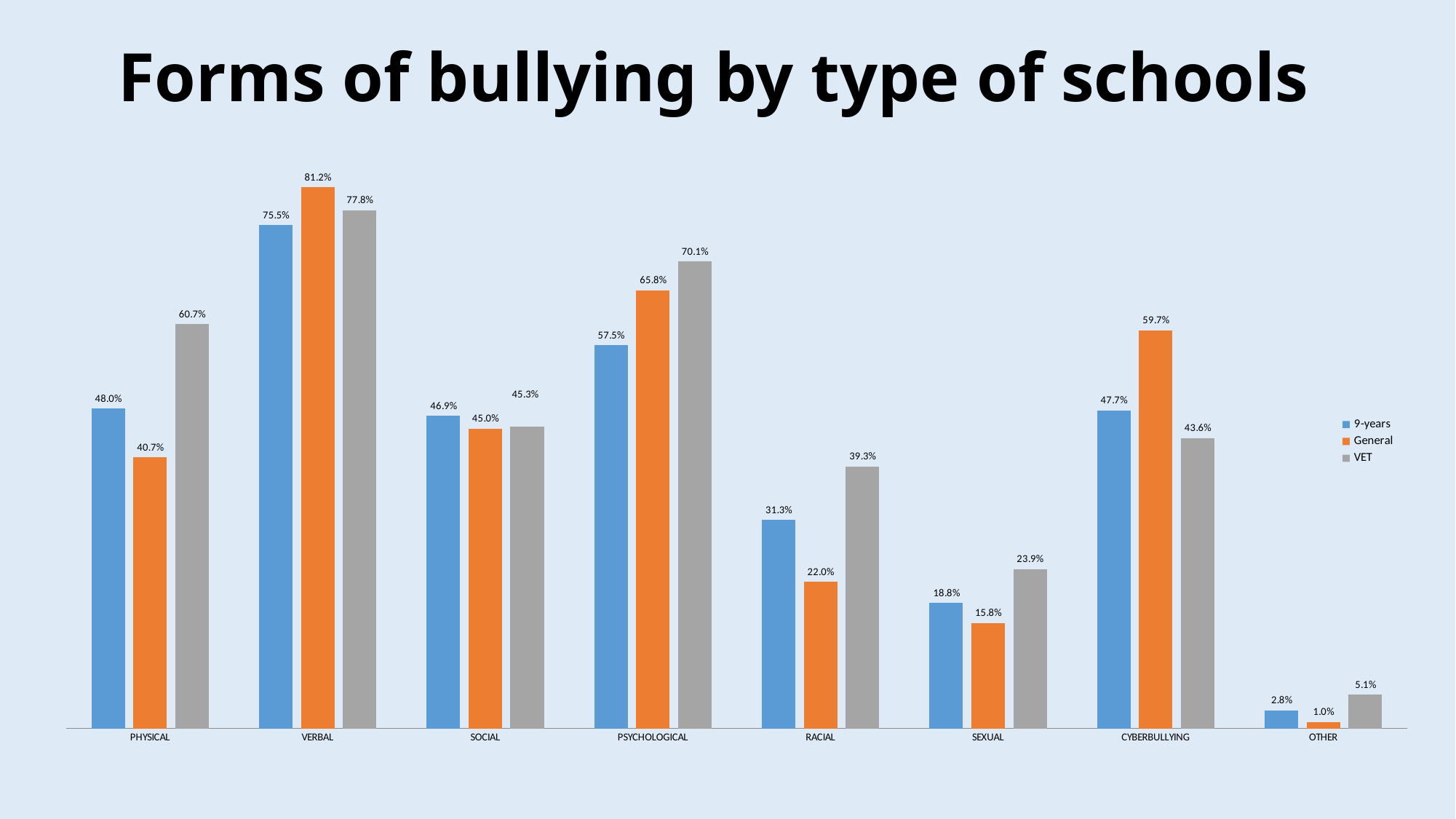
What is the value for General in the CYBERBULLYING category? 59.7% Which category has the highest value for the General series? VERBAL How many series does the legend list? 3 What is the value for VET in the PHYSICAL category? 60.7% Which series is shown in orange? General How many categories are shown on the x axis? 8 Which category has the lowest value for the VET series? OTHER What is the value for 9-years in the RACIAL category? 31.3% What is the difference between the General and 9-years values in the VERBAL category? 5.7% Which is larger in the PSYCHOLOGICAL category, the 9-years value or the VET value? VET What is the title of the chart? Forms of bullying by type of schools What kind of chart is shown on the slide? Bar chart